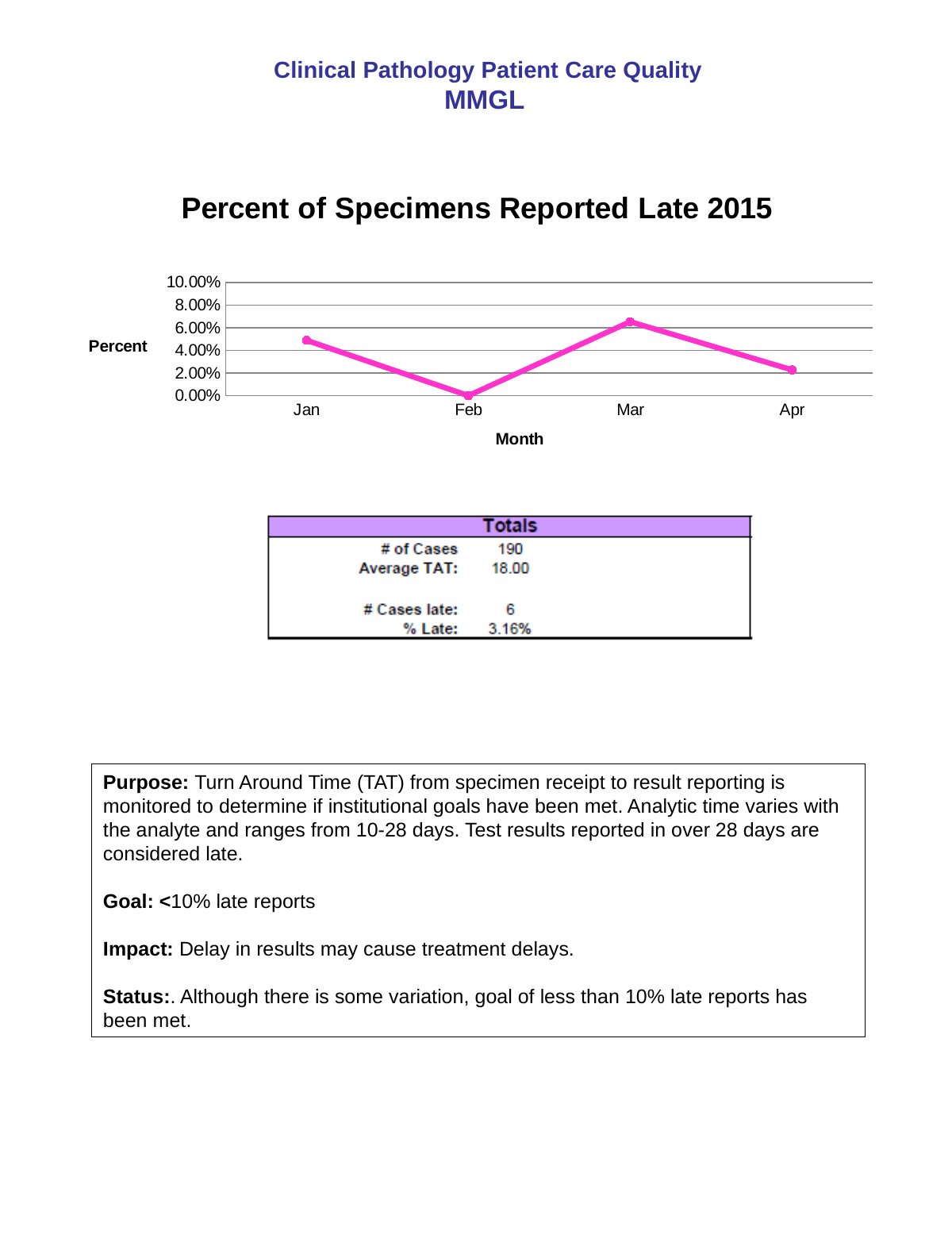
Is the value for Jan greater or less than 4.00%? greater Which month has a higher percent of specimens reported late, Jan or Apr? Jan What kind of chart is shown on the slide? line chart Does the percent of specimens reported late rise or fall from Jan to Feb? fall What is the label of the x axis? Month Is the value for Apr greater or less than 4.00%? less What is the percent of specimens reported late in Feb? 0.00% What is the title of the chart? Percent of Specimens Reported Late 2015 Which month has the lowest percent of specimens reported late? Feb Which month has the highest percent of specimens reported late? Mar How many months are plotted on the chart? 4 Is the value for Mar greater or less than 6.00%? greater